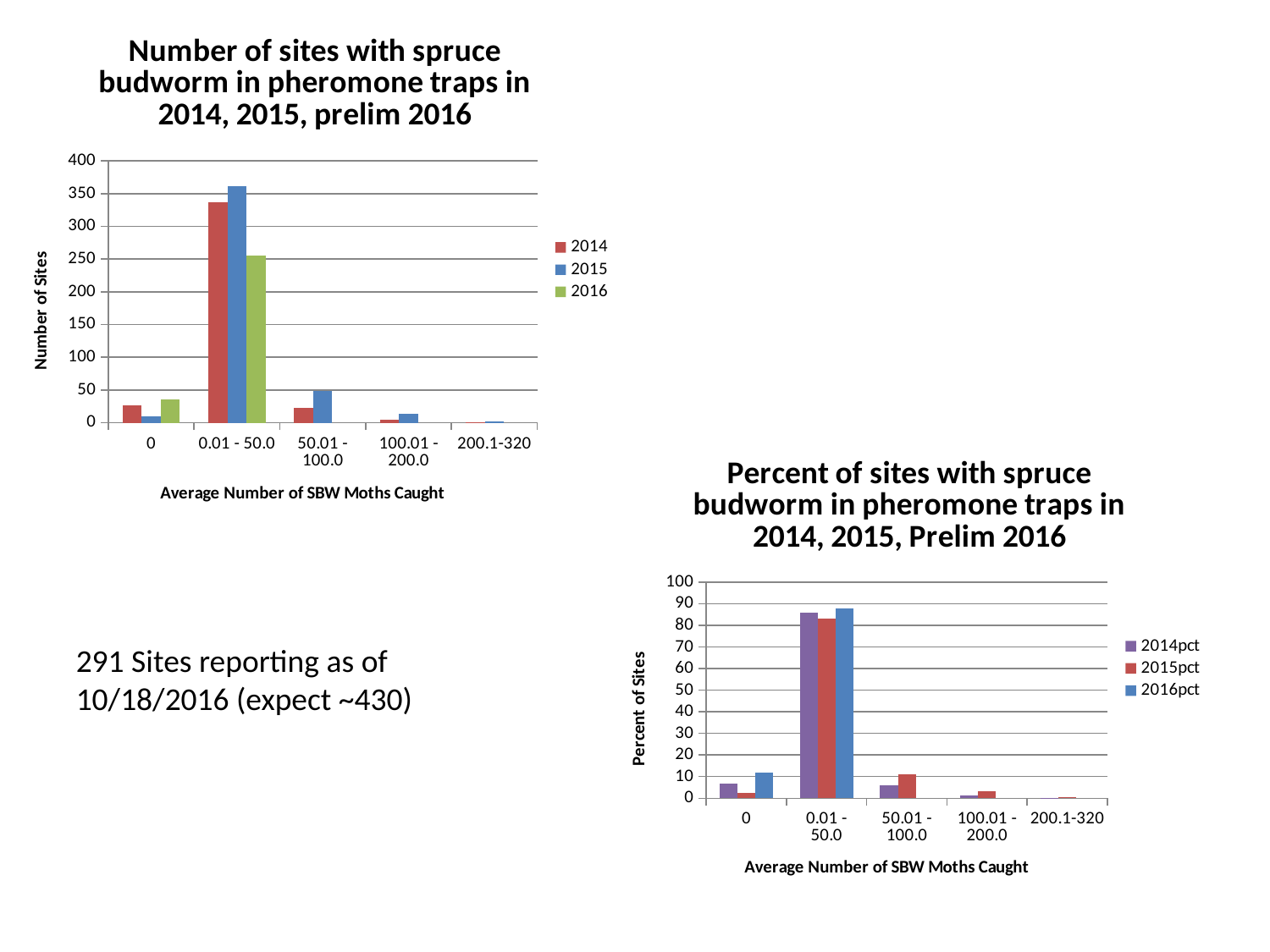
In the chart titled 'Number of sites with spruce budworm in pheromone traps in 2014, 2015, prelim 2016', is the 2015 value for 0.01 - 50.0 greater or less than 300? greater In the chart titled 'Number of sites with spruce budworm in pheromone traps in 2014, 2015, prelim 2016', which series has the larger value for 0.01 - 50.0, 2014 or 2016? 2014 In the chart titled 'Number of sites with spruce budworm in pheromone traps in 2014, 2015, prelim 2016', is the 2015 value for 50.01 - 100.0 greater or less than 100? less In the chart titled 'Percent of sites with spruce budworm in pheromone traps in 2014, 2015, Prelim 2016', which series has the larger value for the 0 category, 2015pct or 2016pct? 2016pct In the chart titled 'Number of sites with spruce budworm in pheromone traps in 2014, 2015, prelim 2016', how many series does the legend list? 3 In the chart titled 'Number of sites with spruce budworm in pheromone traps in 2014, 2015, prelim 2016', is the 2016 value for 0.01 - 50.0 greater or less than 300? less In the chart titled 'Number of sites with spruce budworm in pheromone traps in 2014, 2015, prelim 2016', how many categories are shown on the x axis? 5 In the chart titled 'Number of sites with spruce budworm in pheromone traps in 2014, 2015, prelim 2016', which category has the highest value for 2015? 0.01 - 50.0 In the chart titled 'Number of sites with spruce budworm in pheromone traps in 2014, 2015, prelim 2016', what kind of chart is shown? bar chart In the chart titled 'Percent of sites with spruce budworm in pheromone traps in 2014, 2015, Prelim 2016', how many series does the legend list? 3 In the chart titled 'Percent of sites with spruce budworm in pheromone traps in 2014, 2015, Prelim 2016', what is the title of the y axis? Percent of Sites